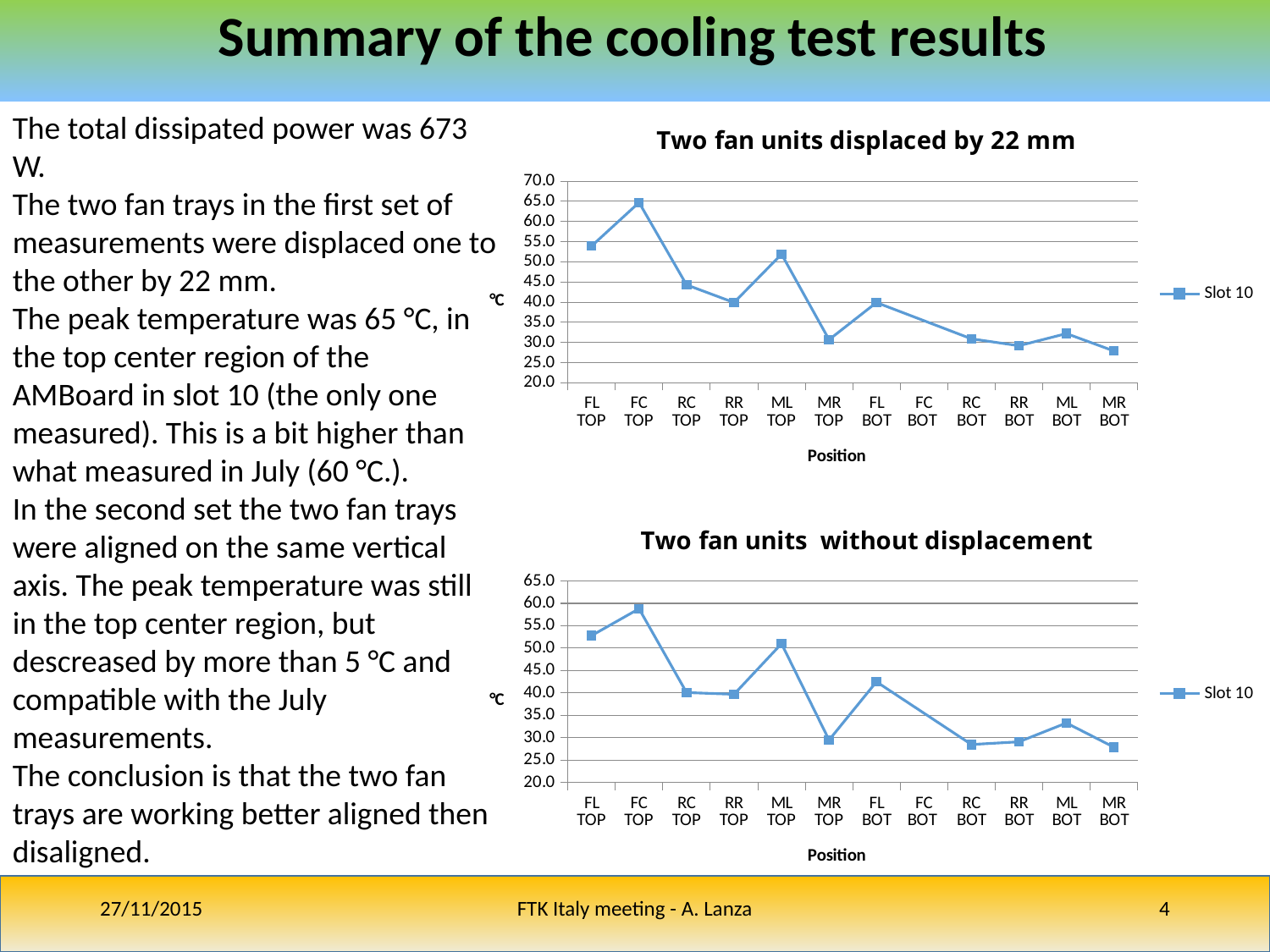
In the chart titled "Two fan units without displacement", which position has the highest temperature? FC TOP What kind of chart is the chart titled "Two fan units displaced by 22 mm"? Line chart In the chart titled "Two fan units displaced by 22 mm", which is larger, the value for FC TOP or the value for FL TOP? FC TOP What is the name of the series shown in the legend of the chart titled "Two fan units displaced by 22 mm"? Slot 10 In the chart titled "Two fan units displaced by 22 mm", is the value for MR TOP greater or less than 35.0? less How many series does the legend of the chart titled "Two fan units without displacement" list? 1 In the chart titled "Two fan units without displacement", is the value for ML TOP greater or less than 45.0? greater In the chart titled "Two fan units displaced by 22 mm", which position has the highest temperature? FC TOP In the chart titled "Two fan units displaced by 22 mm", is the value for FC TOP greater or less than 60.0? greater How many positions are plotted along the x axis of the chart titled "Two fan units displaced by 22 mm"? 12